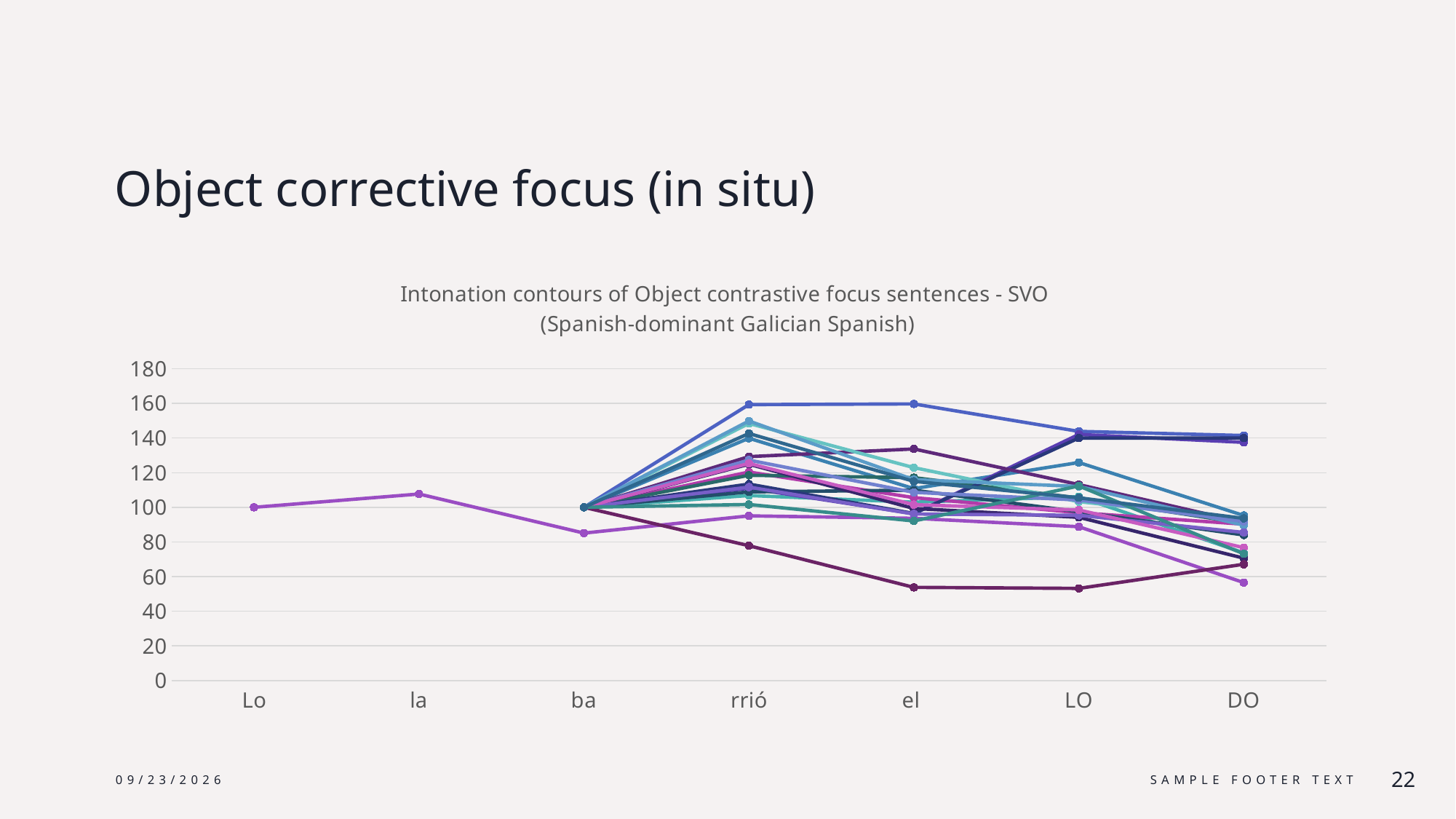
Is the highest value plotted at "LO" greater or less than 120? greater Is the value plotted at "la" greater or less than 100? greater What kind of chart is shown on the slide? line chart How many categories are on the x axis of the chart? 7 What is the title of the chart? Intonation contours of Object contrastive focus sentences - SVO (Spanish-dominant Galician Spanish) Is the lowest value plotted at "el" greater or less than 60? less Does the line rise or fall between "la" and "ba"? fall At which value do all the lines converge at the category "ba"? 100 What is the highest tick value shown on the y axis? 180 What is the value of the single plotted point at "Lo"? 100